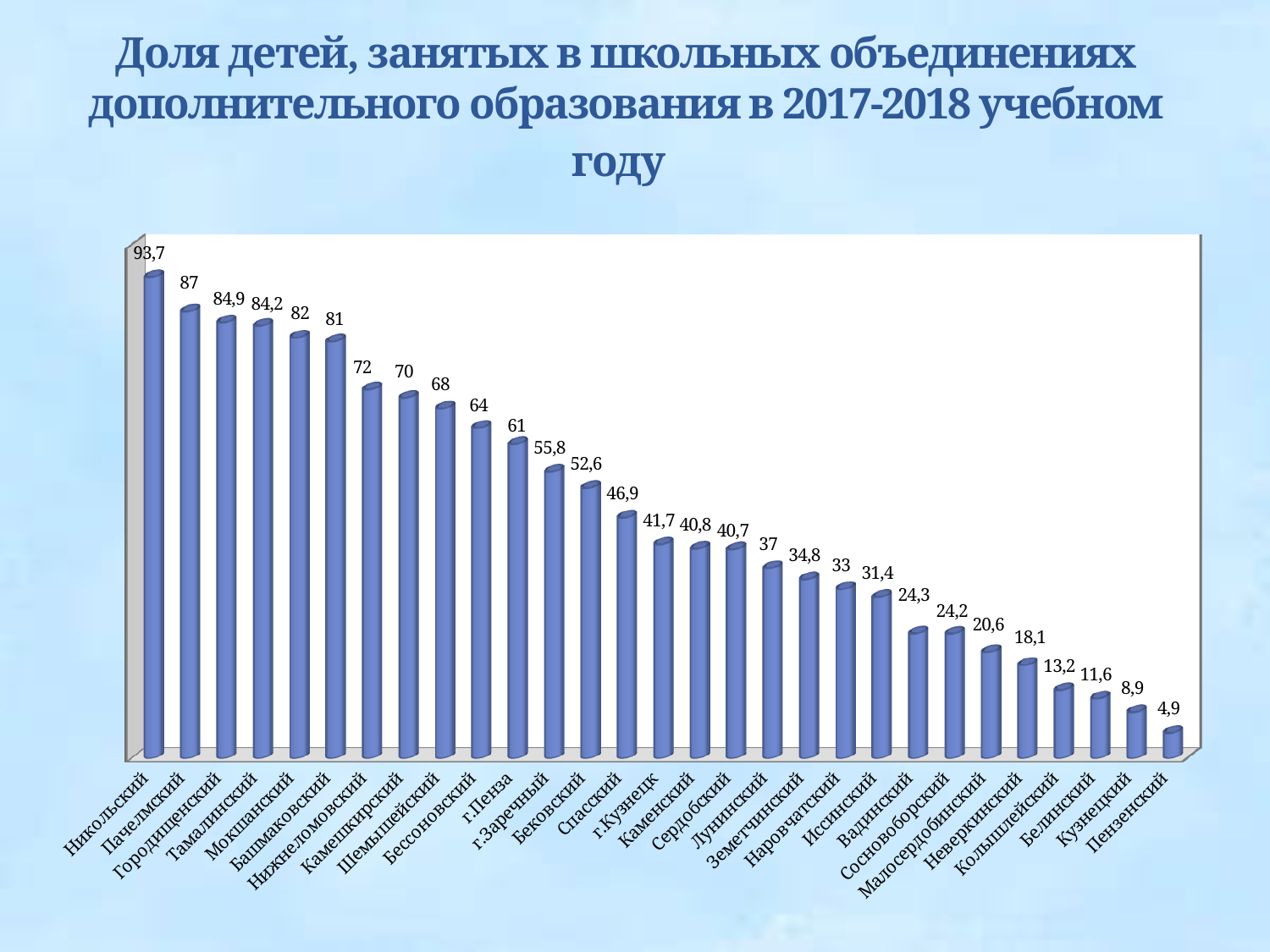
What value is shown for Никольский? 93,7 Which category has the lowest value? Пензенский What is the difference between the values for Пачелмский and Мокшанский? 5 What value is shown for Пензенский? 4,9 What value is shown for г.Пенза? 61 Which category has the highest value? Никольский Do the values rise or fall from left to right along the x axis? Fall How many categories are shown on the chart? 29 What value is shown for Сердобский? 40,7 What kind of chart is shown on the slide? Bar chart Which has a larger value, Спасский or Лунинский? Спасский What is the difference between the values for г.Заречный and Бековский? 3,2